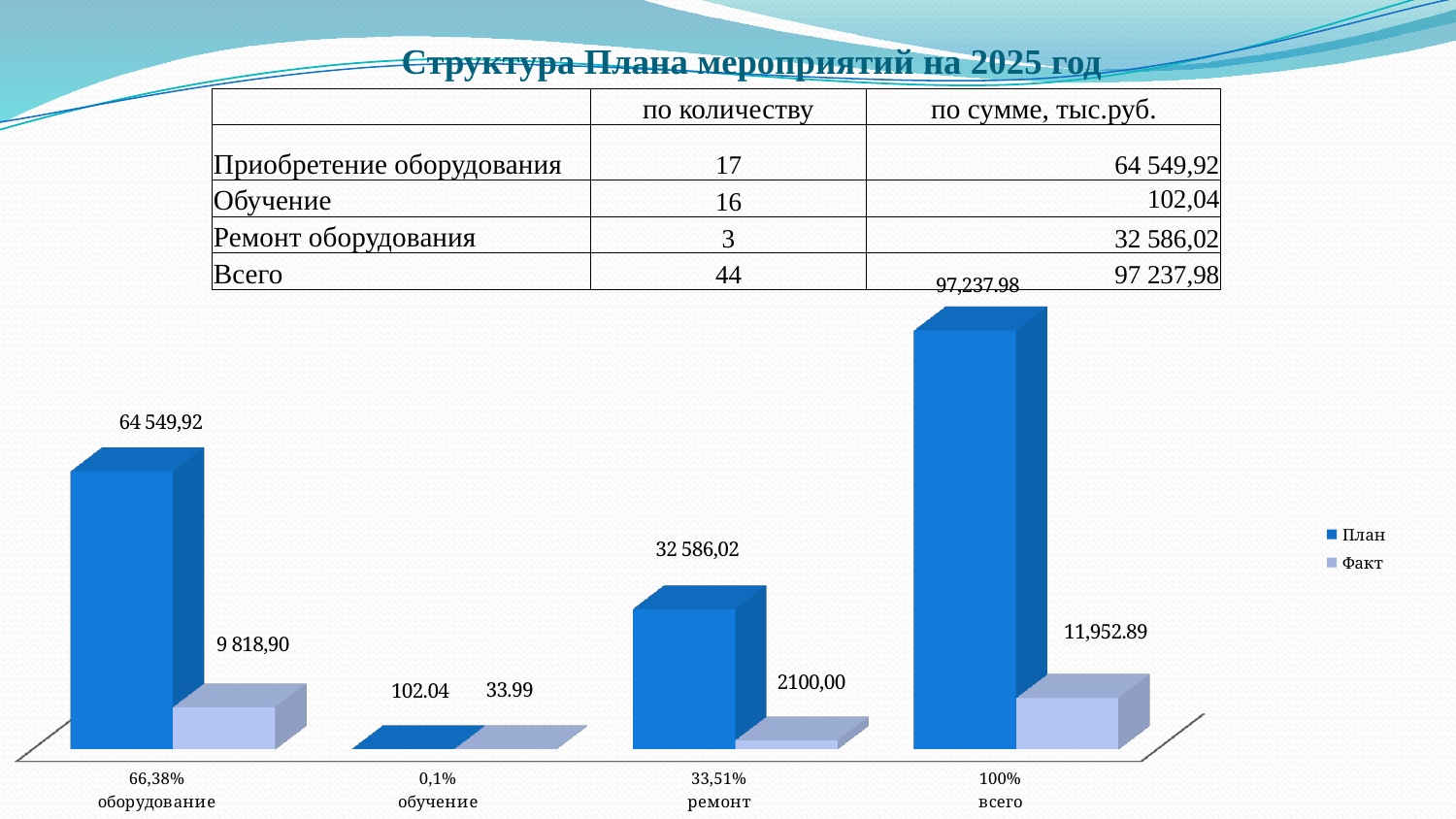
What is the difference between the План and Факт values for оборудование? 54 731,02 What kind of chart is shown on the slide? bar chart What is the Факт value for обучение? 33.99 Which is larger for ремонт, the План value or the Факт value? План What is the План value for ремонт? 32 586,02 How many categories are shown on the x axis of the chart? 4 Which category has the lowest План value? обучение Which category has the highest План value? всего How many series does the legend list? 2 What is the План value for оборудование? 64 549,92 What is the Факт value for всего? 11,952.89 What is the Факт value for оборудование? 9 818,90